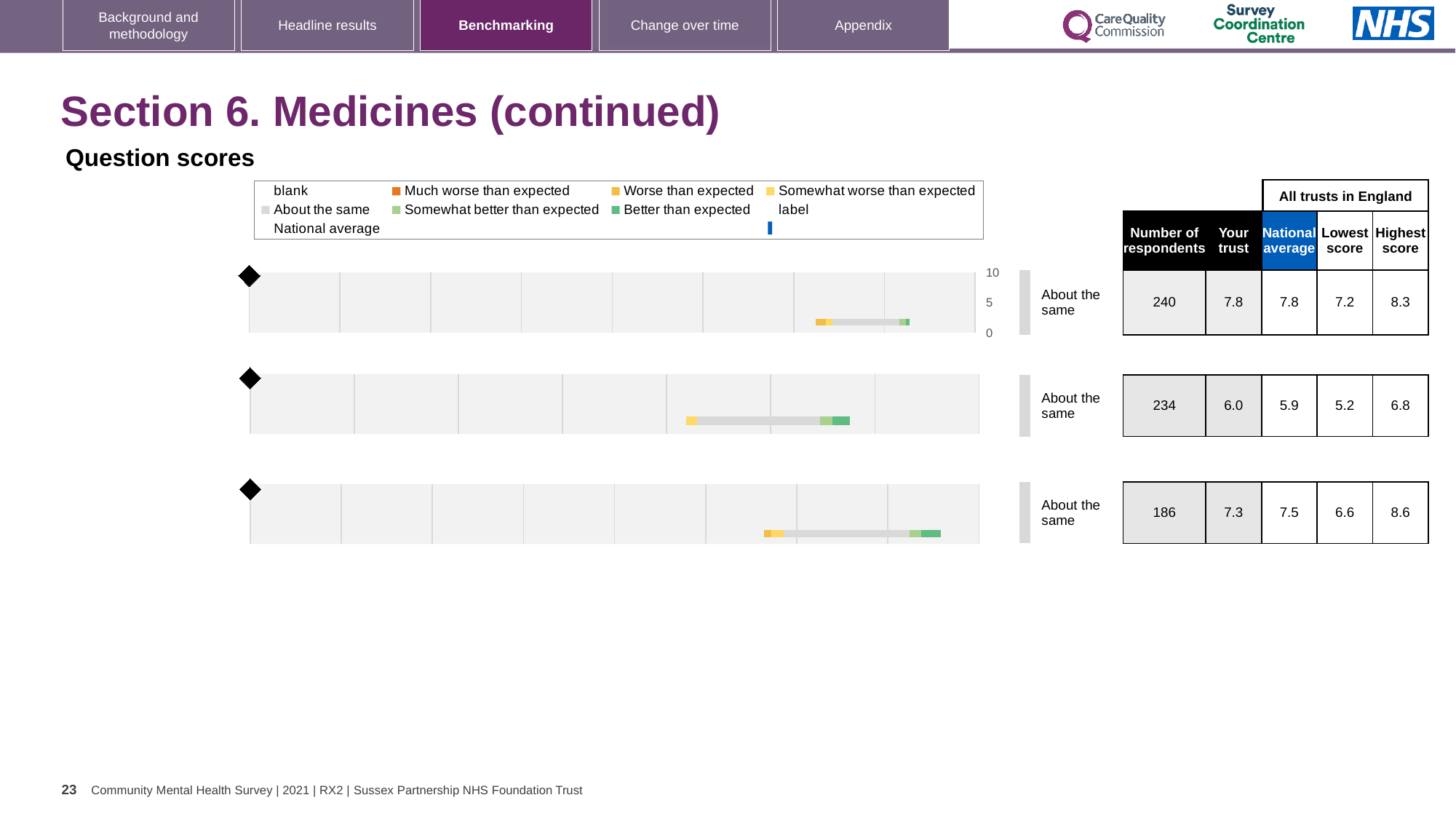
How many question charts are shown on the slide? 3 According to the legend, what does the blue marker represent? National average Which chart (top, middle or bottom) has the highest 'Your trust' score? Top In the table row for the bottom chart, what is the national average score? 7.5 In the table row for the middle chart, what is the 'Your trust' score? 6.0 In the table row for the top chart, what is the number of respondents? 240 For the bottom chart, what is the difference between the highest score (8.6) and the lowest score (6.6)? 2.0 What benchmark category label is shown next to each of the three charts? About the same For the middle chart, what is the difference between the 'Your trust' score and the national average? 0.1 In the table row for the middle chart, what is the lowest score among all trusts in England? 5.2 Which chart (top, middle or bottom) has the lowest number of respondents? Bottom For the bottom chart, which is larger: the 'Your trust' score or the national average? National average